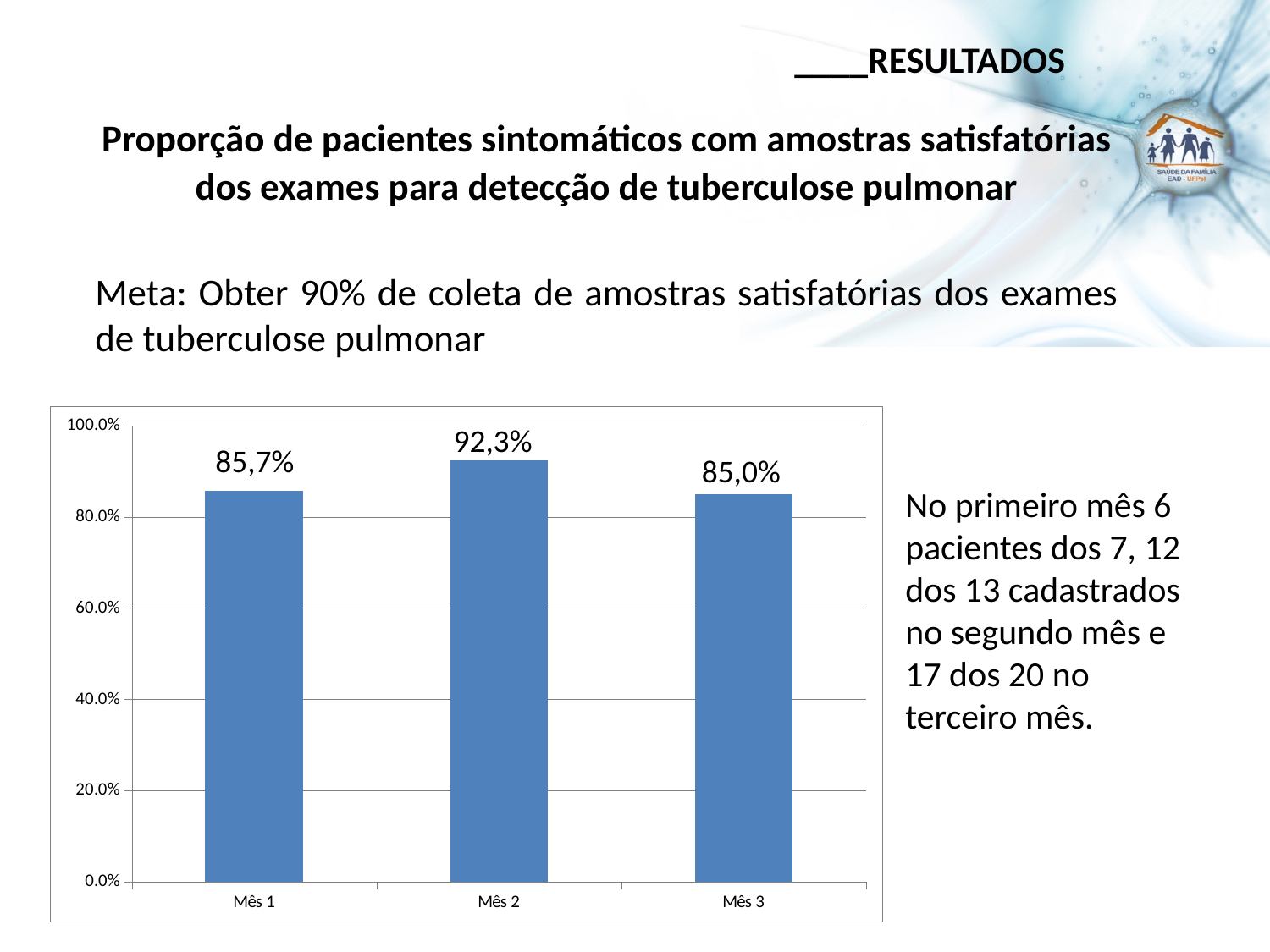
What kind of chart is shown on the slide? Bar chart Is the value for Mês 2 greater or less than 80.0%? greater What is the highest tick value shown on the y axis of the chart? 100.0% What is the value shown for Mês 1? 85,7% What is the value shown for Mês 3? 85,0% Which month has the highest value? Mês 2 Which is larger, the value for Mês 2 or the value for Mês 3? Mês 2 What is the value shown for Mês 2? 92,3% Which month has the lowest value? Mês 3 How many months are shown on the x axis of the chart? 3 What is the difference between the values for Mês 2 and Mês 1? 6,6% What is the difference between the values for Mês 1 and Mês 3? 0,7%